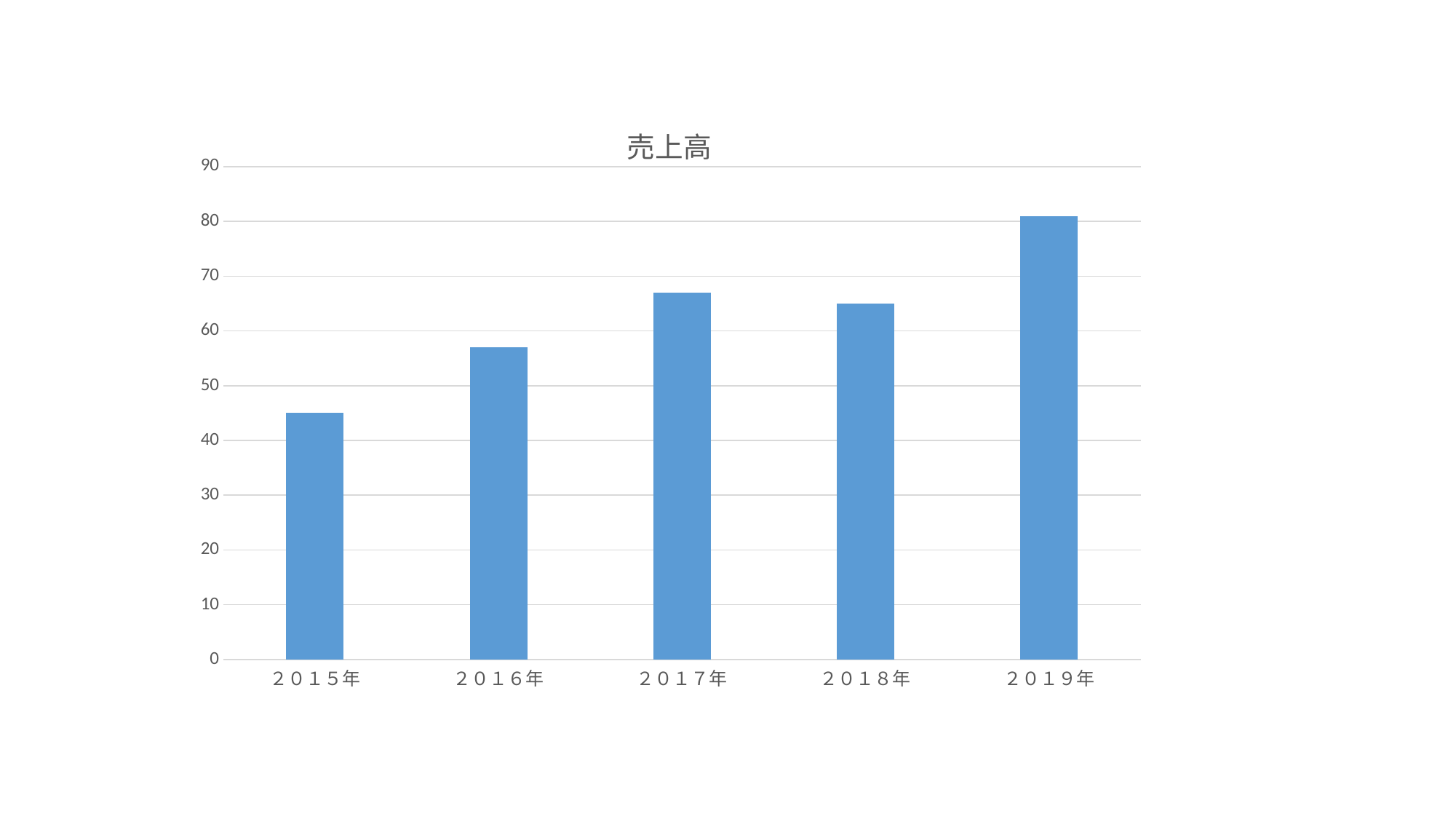
What type of chart is shown on the slide? bar chart Is the value for 2015年 greater or less than 50? less What is the title of the chart? 売上高 Is the value for 2016年 greater or less than 50? greater Which is larger, the value for 2017年 or the value for 2016年? 2017年 Does the value rise or fall from 2015年 to 2016年? rise Which is larger, the value for 2019年 or the value for 2015年? 2019年 Which year has the highest value? 2019年 How many categories (years) are shown on the x axis? 5 Is the value for 2018年 greater or less than 70? less Which year has the lowest value? 2015年